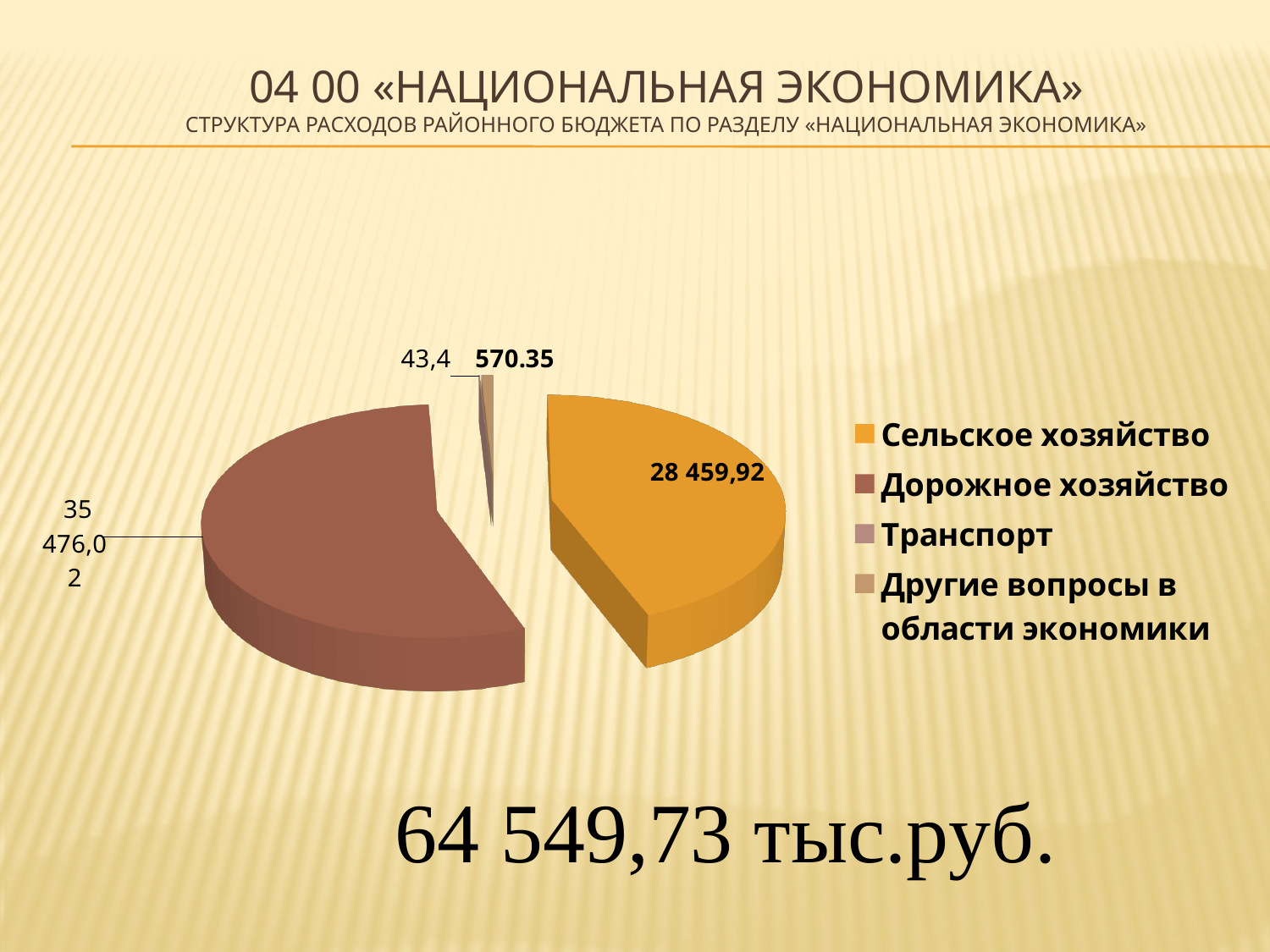
What is the value for Сельское хозяйство? 28 459,92 What total amount is printed below the pie chart? 64 549,73 тыс.руб. What is the largest value labelled on the pie chart? 35 476,02 What is the difference between the values for Дорожное хозяйство and Сельское хозяйство? 7 016,10 What kind of chart is shown on the slide? pie chart How many slices does the pie chart have? 4 How many entries does the legend list? 4 What colour is the slice for Сельское хозяйство? orange Which is larger, Дорожное хозяйство or Сельское хозяйство? Дорожное хозяйство Which category has the largest slice of the pie? Дорожное хозяйство What is the value for Дорожное хозяйство? 35 476,02 What is the smallest value labelled on the pie chart? 43,4